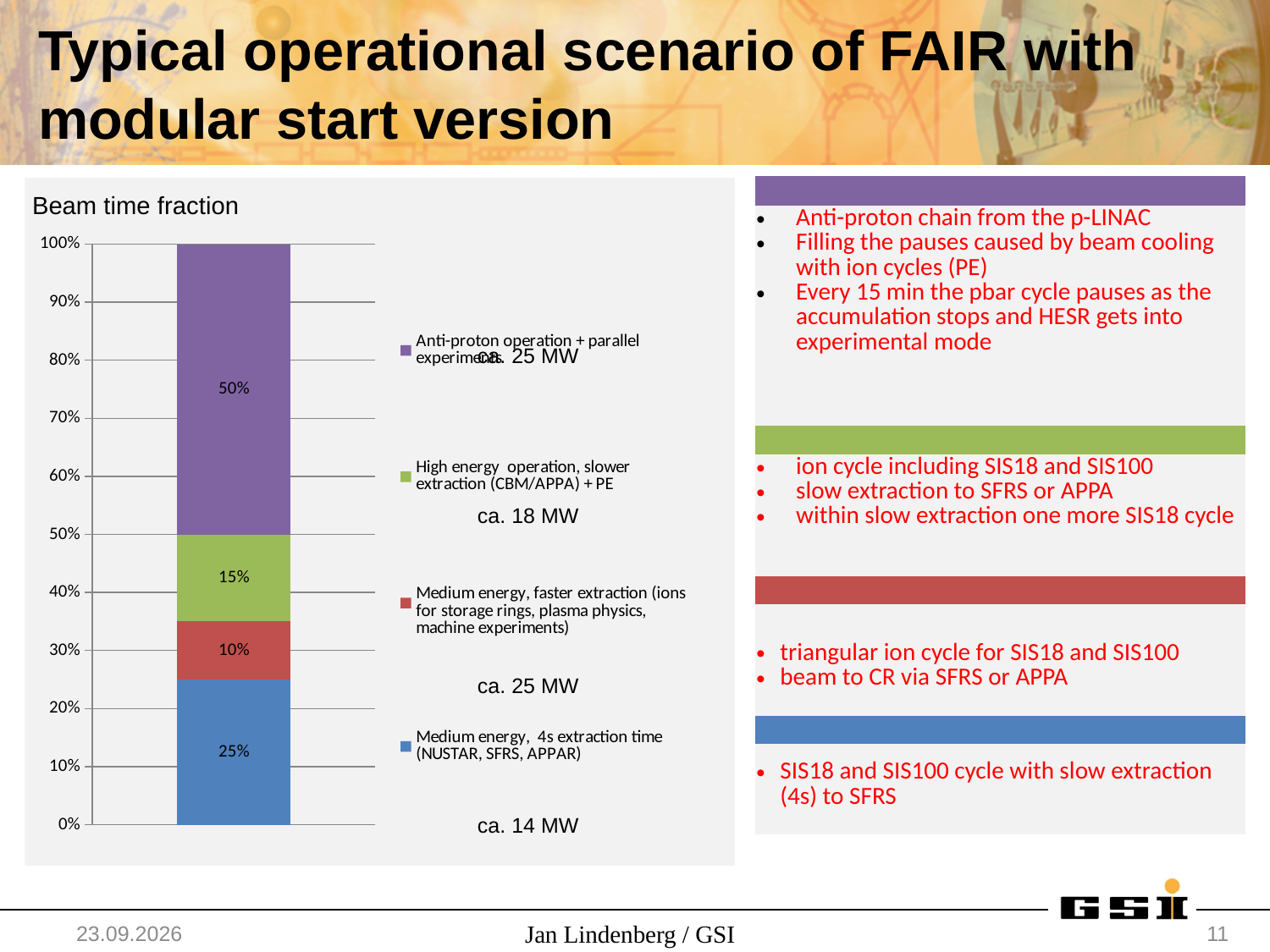
What is the beam time fraction for "Anti-proton operation + parallel experiments"? 50% Which is larger: the beam time fraction for "High energy operation, slower extraction (CBM/APPA) + PE" or for "Medium energy, faster extraction"? High energy operation, slower extraction (CBM/APPA) + PE What is the difference between the beam time fraction for "Anti-proton operation + parallel experiments" and for "Medium energy, 4s extraction time (NUSTAR, SFRS, APPAR)"? 25% What is the total of the stacked bar in the beam time fraction chart? 100% What is the beam time fraction for "Medium energy, faster extraction (ions for storage rings, plasma physics, machine experiments)"? 10% How many series does the legend of the beam time fraction chart list? 4 What colour is the segment for "Anti-proton operation + parallel experiments" in the beam time fraction chart? Purple What is the beam time fraction for "High energy operation, slower extraction (CBM/APPA) + PE"? 15% Which series has the smallest beam time fraction? Medium energy, faster extraction (ions for storage rings, plasma physics, machine experiments) What is the beam time fraction for "Medium energy, 4s extraction time (NUSTAR, SFRS, APPAR)"? 25% What kind of chart is shown under the heading "Beam time fraction"? Stacked bar chart Which series has the largest beam time fraction? Anti-proton operation + parallel experiments